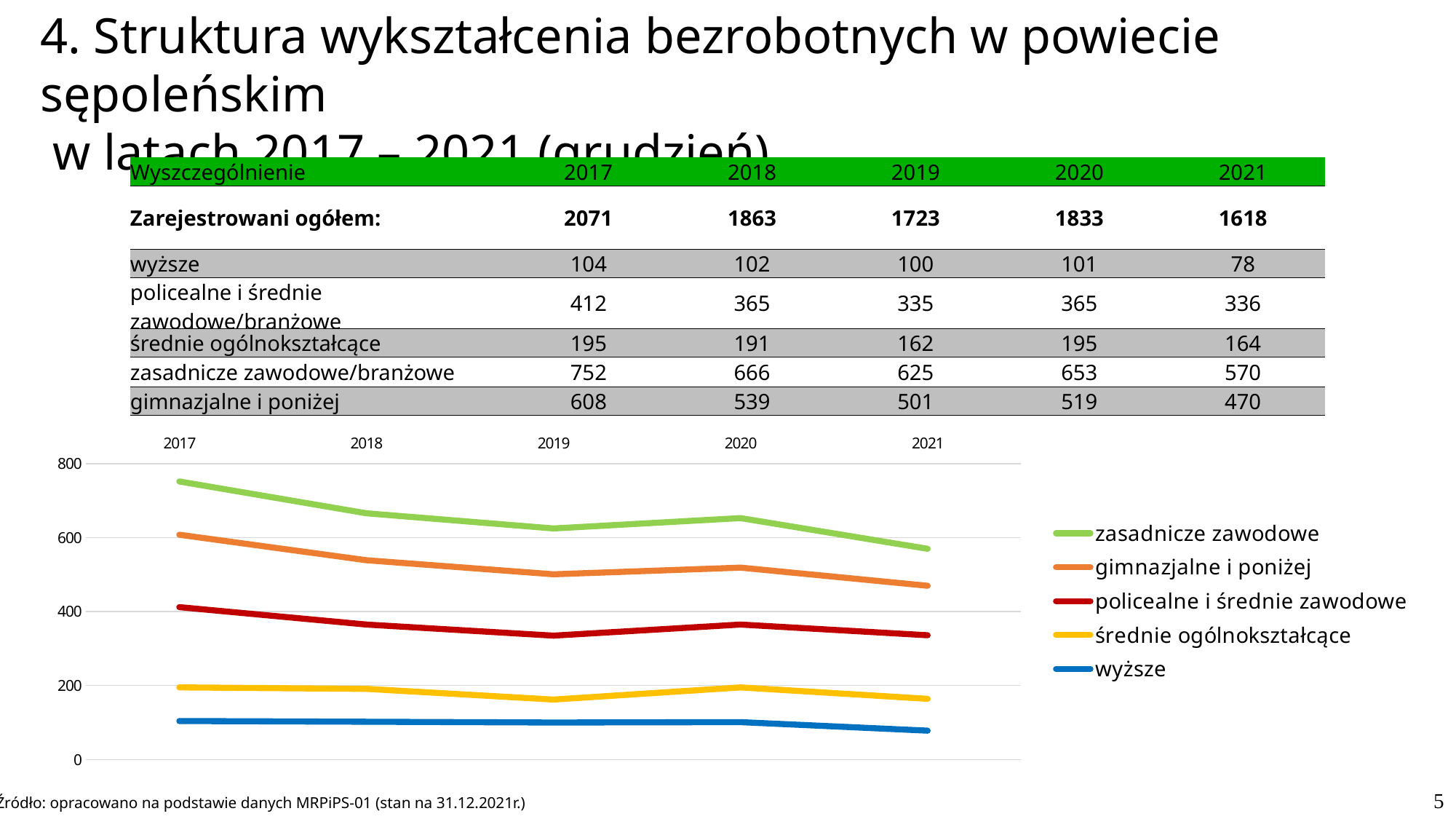
What kind of chart is shown on the slide? line chart Which is larger in 2020: gimnazjalne i poniżej or średnie ogólnokształcące? gimnazjalne i poniżej Is the value for wyższe in 2021 greater or less than 200? less Which series has the lowest values across all years in the chart? wyższe Which series has the highest values across all years in the chart? zasadnicze zawodowe According to the table, what is the value for zasadnicze zawodowe/branżowe in 2021? 570 According to the table, what is the difference between gimnazjalne i poniżej in 2017 and in 2021? 138 Is the value for zasadnicze zawodowe in 2017 greater or less than 600? greater How many years are plotted along the x axis of the chart? 5 How many series does the chart legend list? 5 What colour is the line for wyższe in the chart? blue Does the zasadnicze zawodowe line rise or fall overall from 2017 to 2021? fall